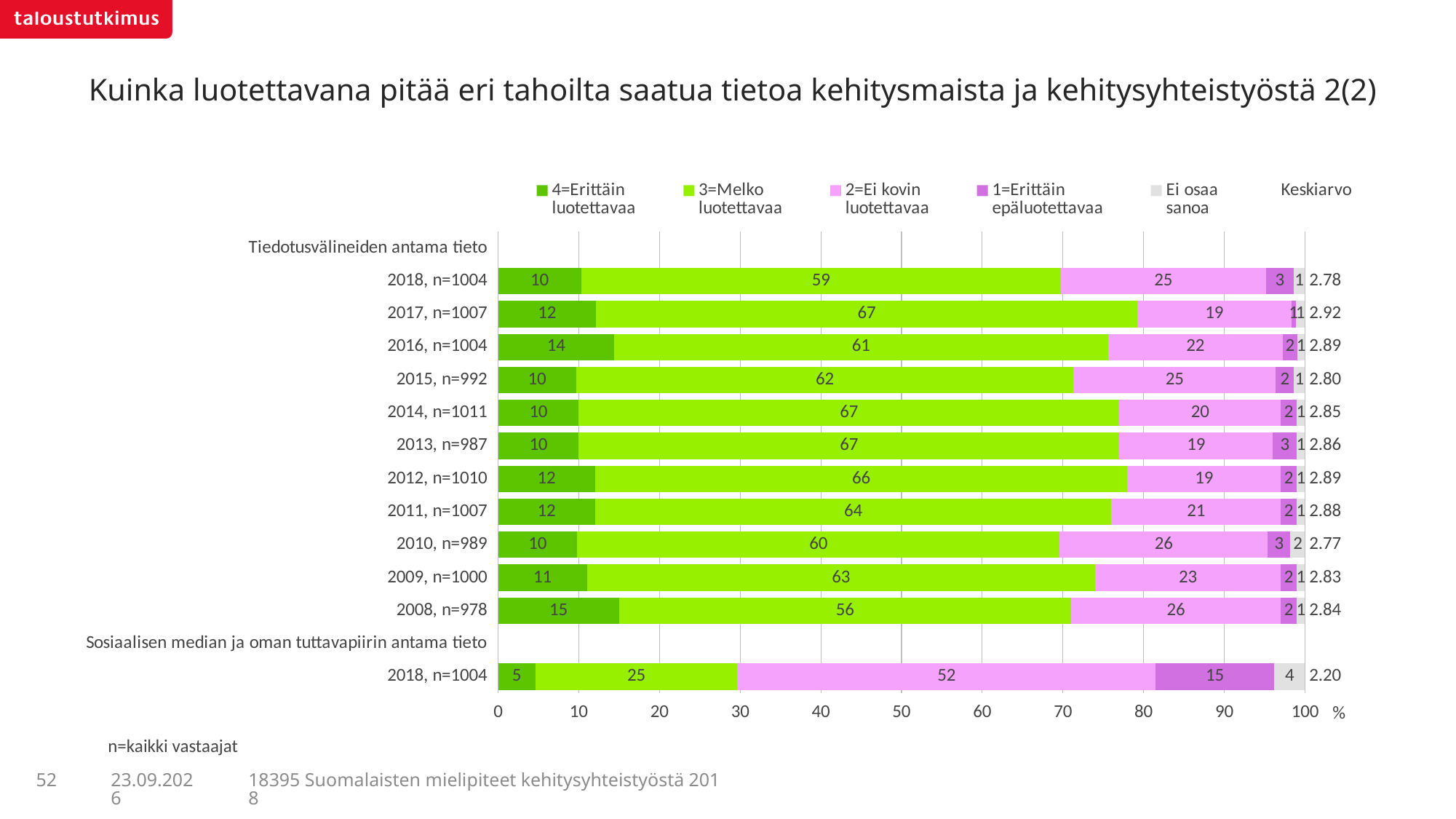
Which year of Tiedotusvälineiden antama tieto has the highest value for "4=Erittäin luotettavaa"? 2008, n=978 What is the difference between the "3=Melko luotettavaa" values for Tiedotusvälineiden antama tieto in 2017, n=1007 and 2018, n=1004? 8 How many entries does the legend list? 6 How many bars (rows of data) are plotted in the chart? 12 What is the value of "3=Melko luotettavaa" for Tiedotusvälineiden antama tieto in 2018, n=1004? 59 What is the Keskiarvo (mean) for Sosiaalisen median ja oman tuttavapiirin antama tieto, 2018, n=1004? 2.20 Which year of Tiedotusvälineiden antama tieto has the highest Keskiarvo? 2017, n=1007 What kind of chart is shown on the slide? Stacked horizontal bar chart What is the value of "2=Ei kovin luotettavaa" for Sosiaalisen median ja oman tuttavapiirin antama tieto, 2018, n=1004? 52 What is the value of "Ei osaa sanoa" for Tiedotusvälineiden antama tieto in 2010, n=989? 2 Which year of Tiedotusvälineiden antama tieto has the lowest Keskiarvo? 2010, n=989 Which is larger: the "1=Erittäin epäluotettavaa" value for Sosiaalisen median ja oman tuttavapiirin antama tieto 2018 or for Tiedotusvälineiden antama tieto 2018? Sosiaalisen median ja oman tuttavapiirin antama tieto 2018